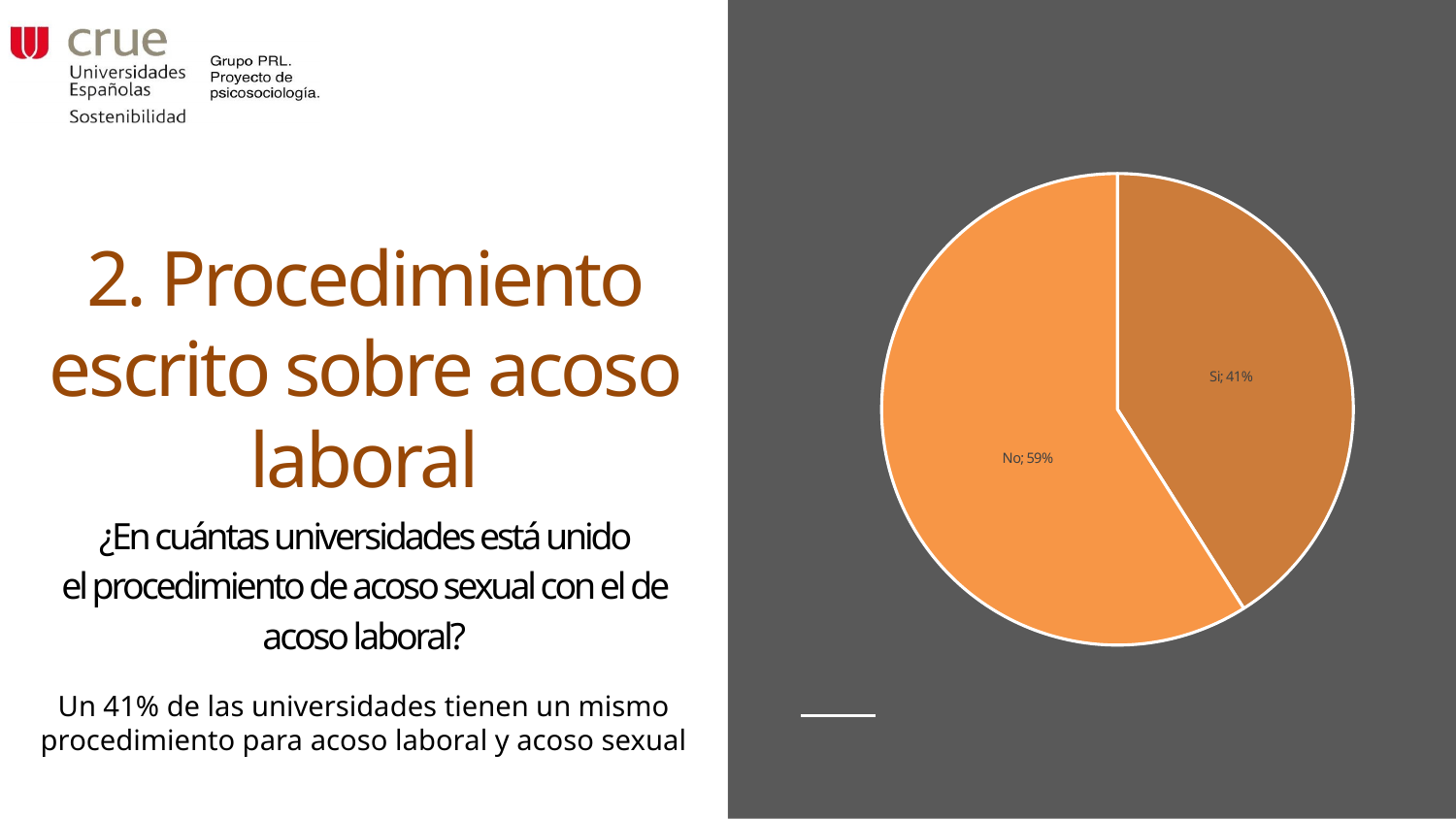
Is the share for "No" greater or less than 50%? greater What is the difference in percentage points between the "No" slice and the "Si" slice? 18 What share of the pie does the "No" slice represent? 59% What share of the pie does the "Si" slice represent? 41% Which slice of the pie is the largest? No What are the labels of the two slices in the pie chart? Si and No Which slice of the pie is the smallest? Si What is the total of the two slices shown in the pie chart? 100% Is the share for "Si" greater or less than 50%? less What kind of chart is shown on the slide? pie chart Which is larger, the "Si" slice or the "No" slice? No How many slices does the pie chart have? 2